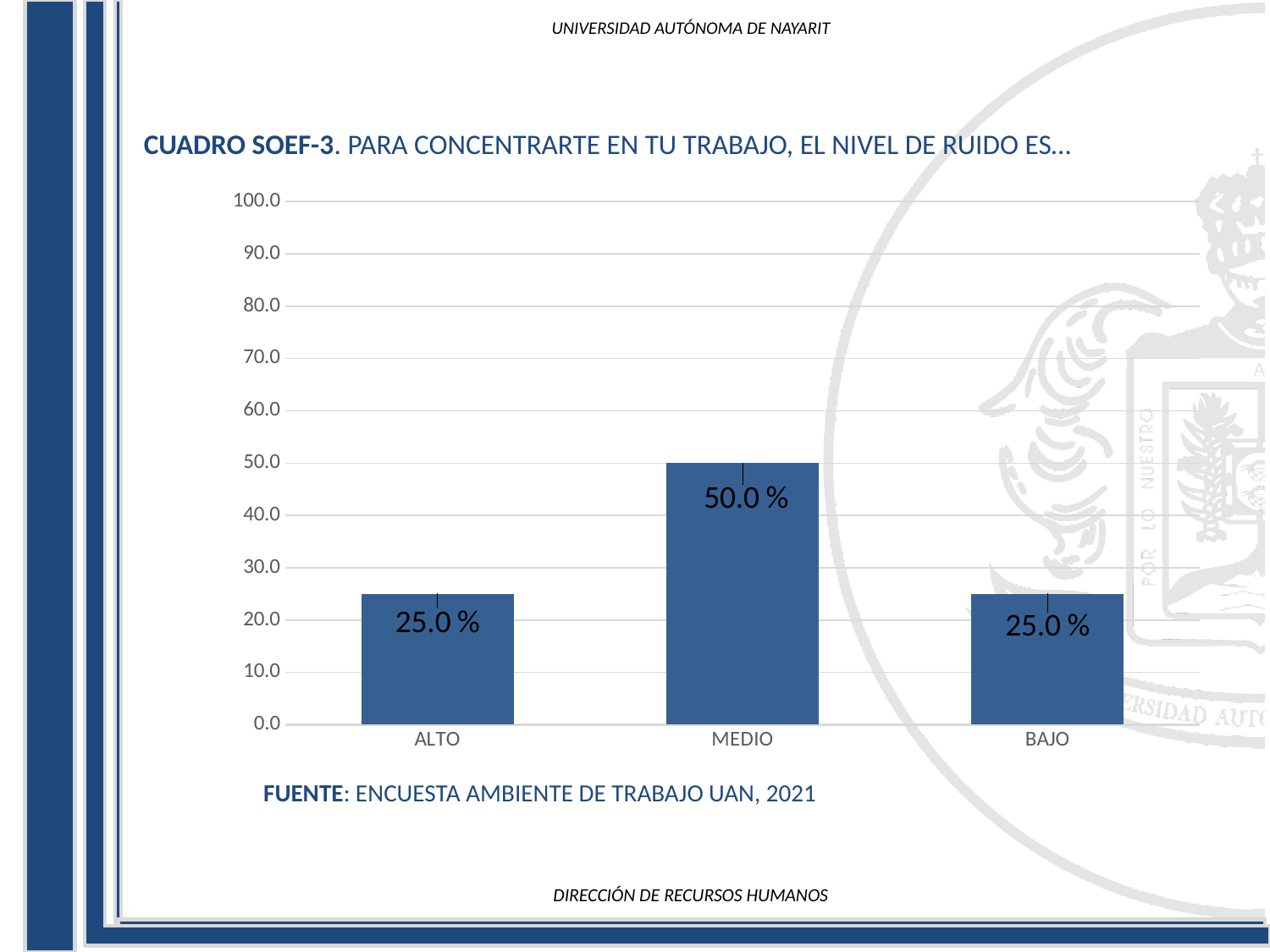
What is the title of the chart? CUADRO SOEF-3. PARA CONCENTRARTE EN TU TRABAJO, EL NIVEL DE RUIDO ES… What is the source cited below the chart? ENCUESTA AMBIENTE DE TRABAJO UAN, 2021 What is the difference between the values for MEDIO and ALTO? 25.0 % What is the value for BAJO? 25.0 % How many categories are shown on the x axis? 3 Is the value for ALTO greater or less than 30.0? less Which is larger, the value for MEDIO or the value for BAJO? MEDIO Is the value for MEDIO greater or less than 40.0? greater Which category has the highest value? MEDIO What is the value for MEDIO? 50.0 % What is the value for ALTO? 25.0 % What kind of chart is shown on the slide? bar chart